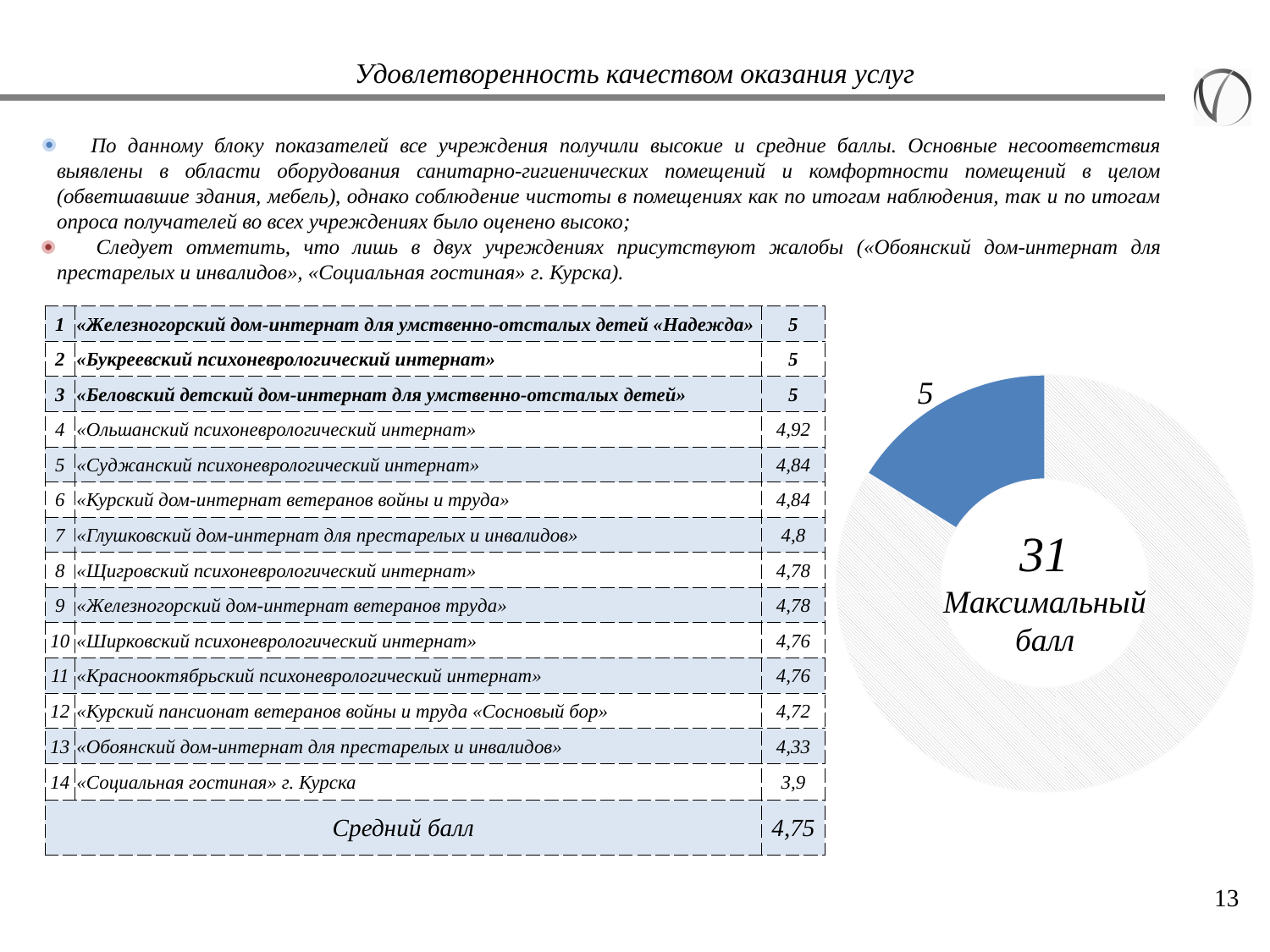
What number is shown in the centre of the doughnut chart? 31 What value is printed on the blue slice of the doughnut chart? 5 What text accompanies the number in the centre of the doughnut chart? Максимальный балл Which slice of the doughnut chart is larger, the blue one or the hatched one? The hatched one What kind of chart is shown on the right side of the slide? Doughnut (pie) chart